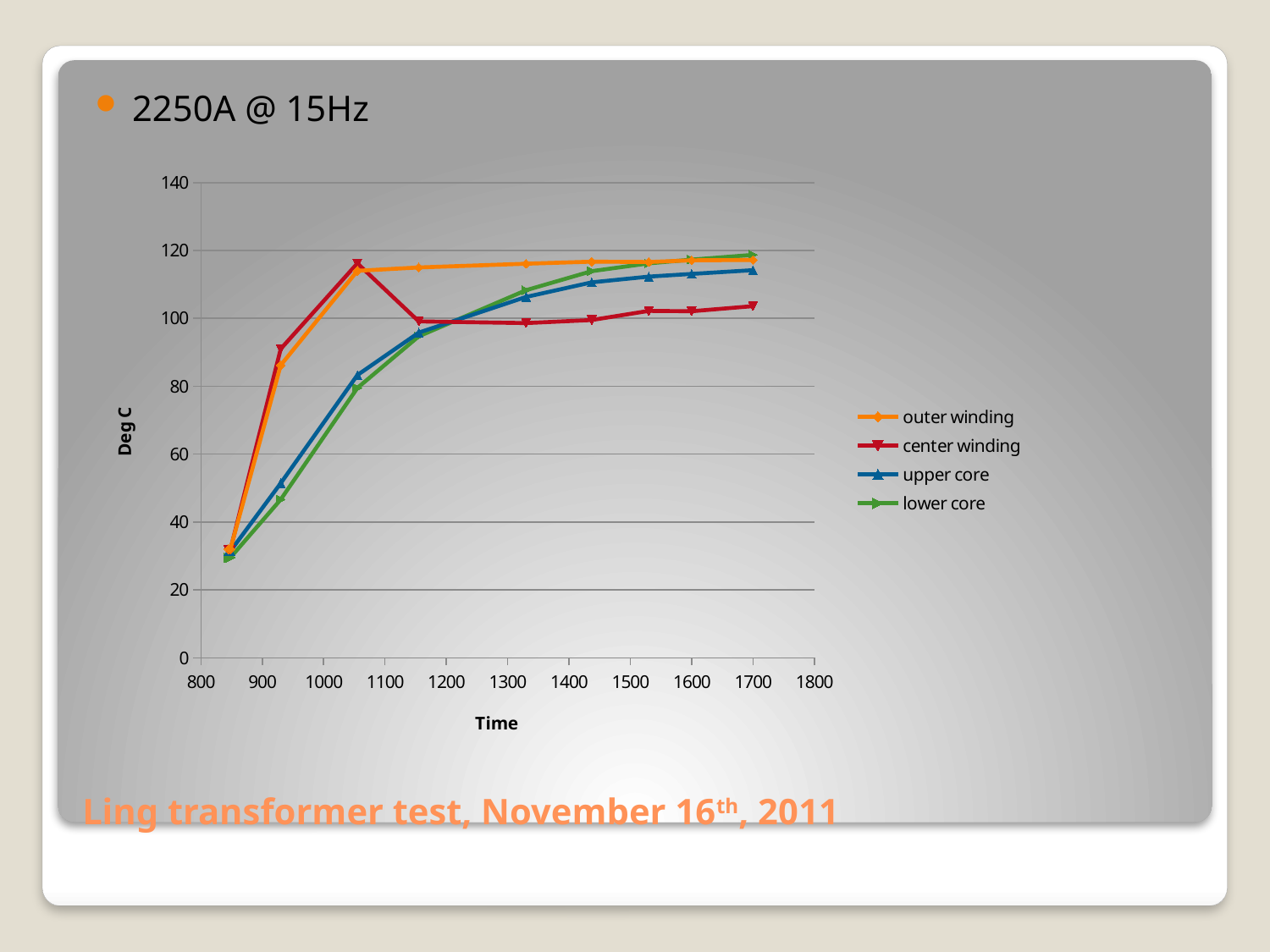
Does the outer winding series rise or fall overall as time increases? rise Is the final value of the outer winding series (at about time 1700) greater or less than 100? greater What is the title of the horizontal axis? Time Is the first value of the upper core series (at about time 850) greater or less than 40? less At the last time point, which is higher: lower core or center winding? lower core At the last time point, which is higher: outer winding or center winding? outer winding What is the highest value labelled on the vertical axis? 140 What kind of chart is shown on the slide? line chart What is the title of the vertical axis? Deg C Which series has the lowest value at the last time point? center winding How many series does the legend list? 4 Is the final value of the center winding series (at about time 1700) greater or less than 120? less